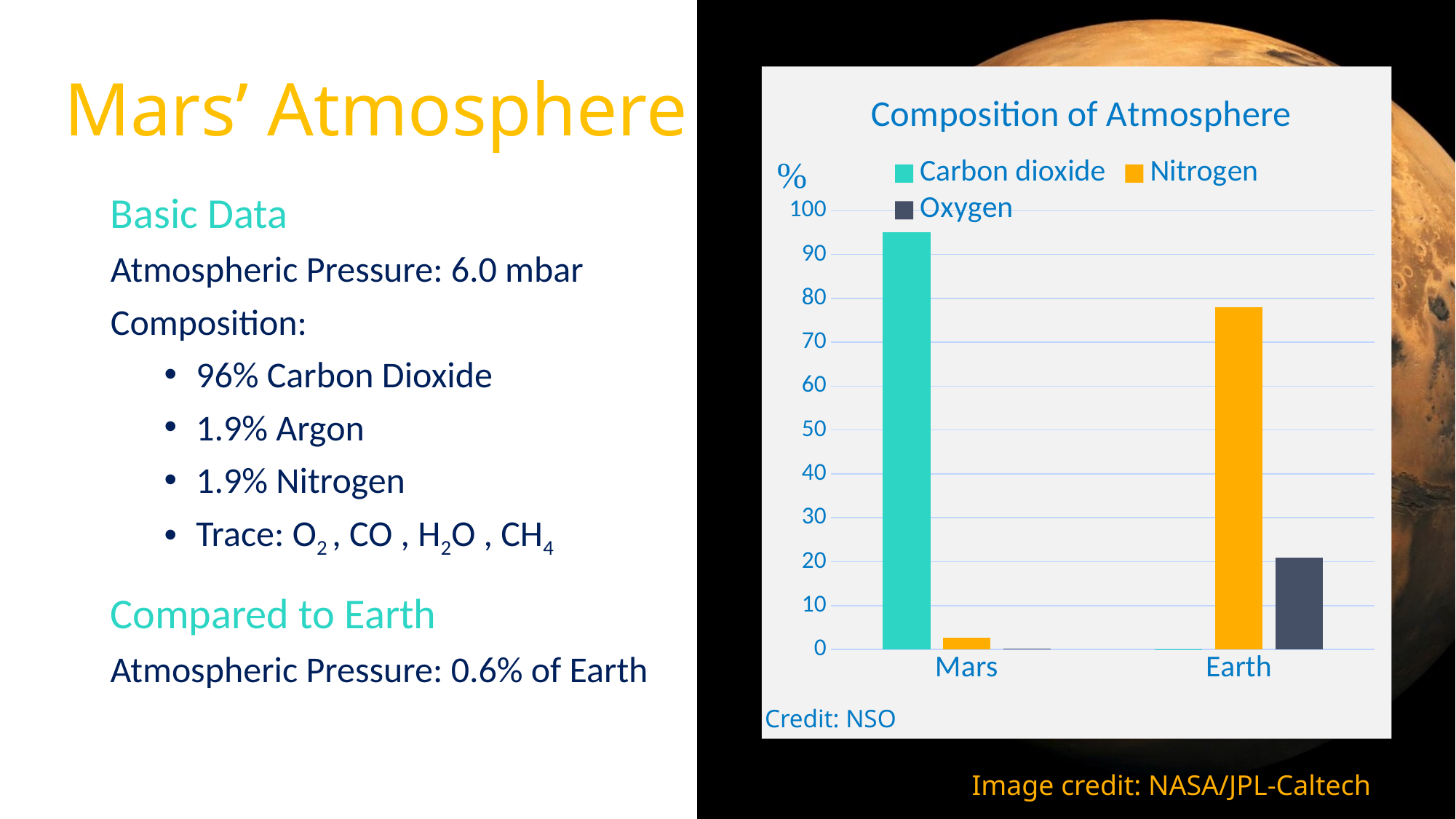
How many series does the legend of the Composition of Atmosphere chart list? 3 Is the Nitrogen value for Mars greater or less than 10? less Is the Nitrogen value for Earth greater or less than 70? greater What is the title of the chart on the slide? Composition of Atmosphere Is the Carbon dioxide value for Mars greater or less than 90? greater Which is larger: the Nitrogen value for Earth or the Oxygen value for Earth? Nitrogen Which series has the highest value for Mars in the Composition of Atmosphere chart? Carbon dioxide Which is larger: the Carbon dioxide value for Mars or the Carbon dioxide value for Earth? Mars Which series has the highest value for Earth in the Composition of Atmosphere chart? Nitrogen How many categories are shown on the x axis of the Composition of Atmosphere chart? 2 What type of chart is shown on the slide? bar chart